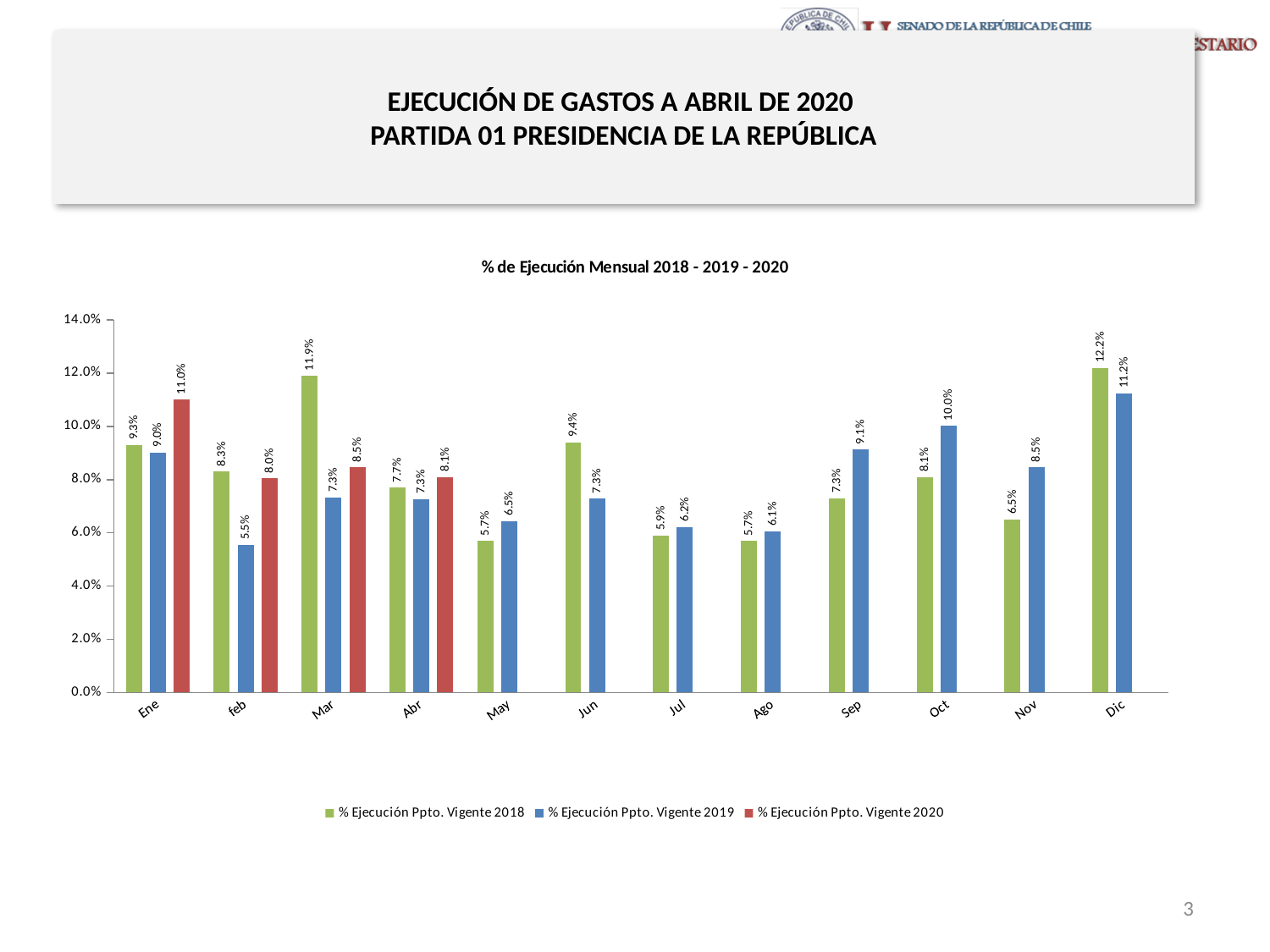
Is the % Ejecución Ppto. Vigente 2019 value for feb greater or less than 6.0%? less What is the title of the chart? % de Ejecución Mensual 2018 - 2019 - 2020 Which is larger for Sep: the 2018 value or the 2019 value? 2019 value How many months are shown on the x axis? 12 Which month has the highest % Ejecución Ppto. Vigente 2018 value? Dic What is the difference between the 2018 and 2019 values for Dic? 1.0% What is the % Ejecución Ppto. Vigente 2018 value for Mar? 11.9% What kind of chart is shown on the slide? Bar chart What is the % Ejecución Ppto. Vigente 2019 value for Oct? 10.0% Which month has the lowest % Ejecución Ppto. Vigente 2019 value? feb How many series does the legend list? 3 What is the % Ejecución Ppto. Vigente 2020 value for Ene? 11.0%